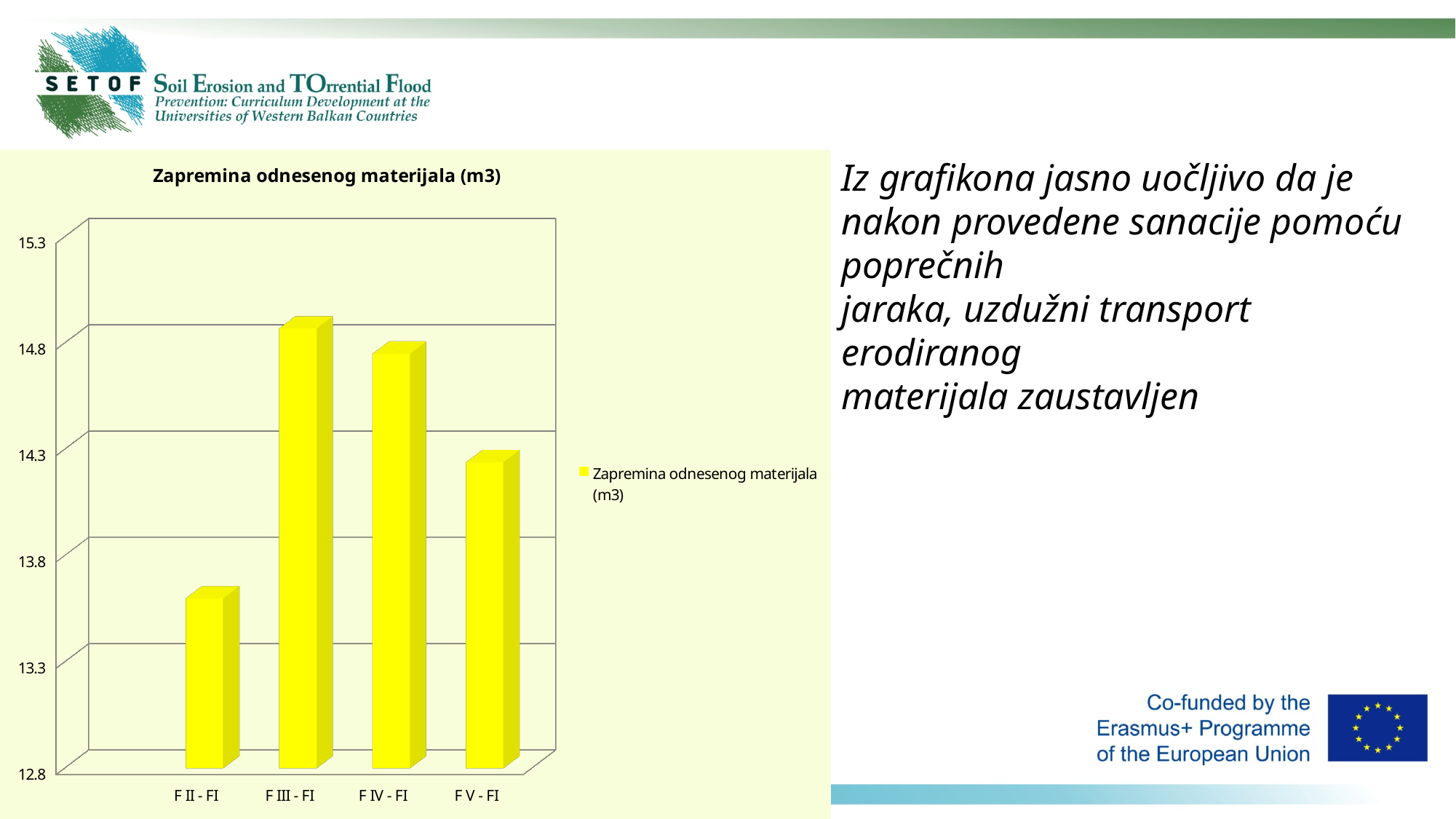
Is the value for F IV - FI greater or less than 14.3? greater Do the values rise or fall from F III - FI to F V - FI along the x axis? fall Is the value for F III - FI greater or less than 14.3? greater Which category has the lowest value in the chart? F II - FI What is the title of the chart? Zapremina odnesenog materijala (m3) Which category has the highest value in the chart? F III - FI Is the value for F II - FI greater or less than 13.8? less What type of chart is shown on the slide? bar chart How many series does the chart's legend list? 1 Which is larger, the value for F II - FI or the value for F V - FI? F V - FI How many categories are shown on the x axis of the chart? 4